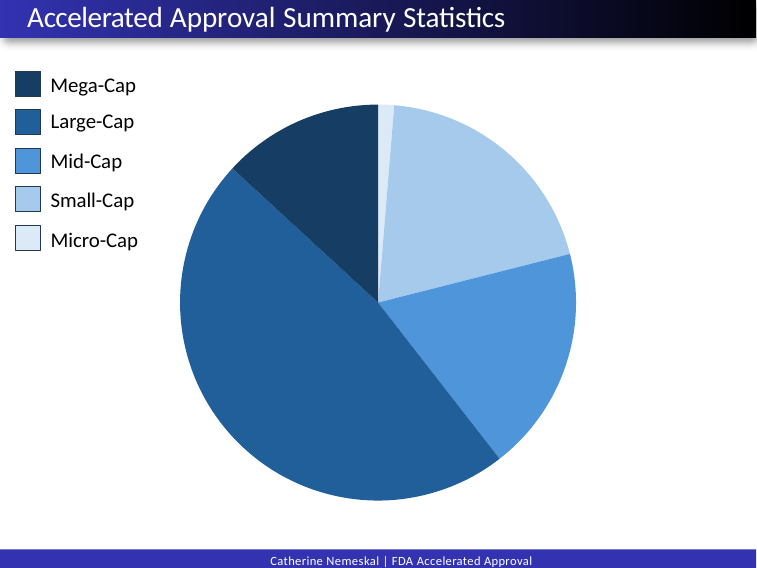
What kind of chart is shown on the slide? pie chart Which category is shown in the darkest blue in the legend? Mega-Cap Which slice is larger, Mega-Cap or Micro-Cap? Mega-Cap Which slice is larger, Large-Cap or Small-Cap? Large-Cap Which category has the smallest slice of the pie chart? Micro-Cap Which category has the largest slice of the pie chart? Large-Cap What is the title of the slide containing the pie chart? Accelerated Approval Summary Statistics Which slice is larger, Micro-Cap or Mid-Cap? Mid-Cap How many entries does the legend list? 5 How many categories (slices) does the pie chart have? 5